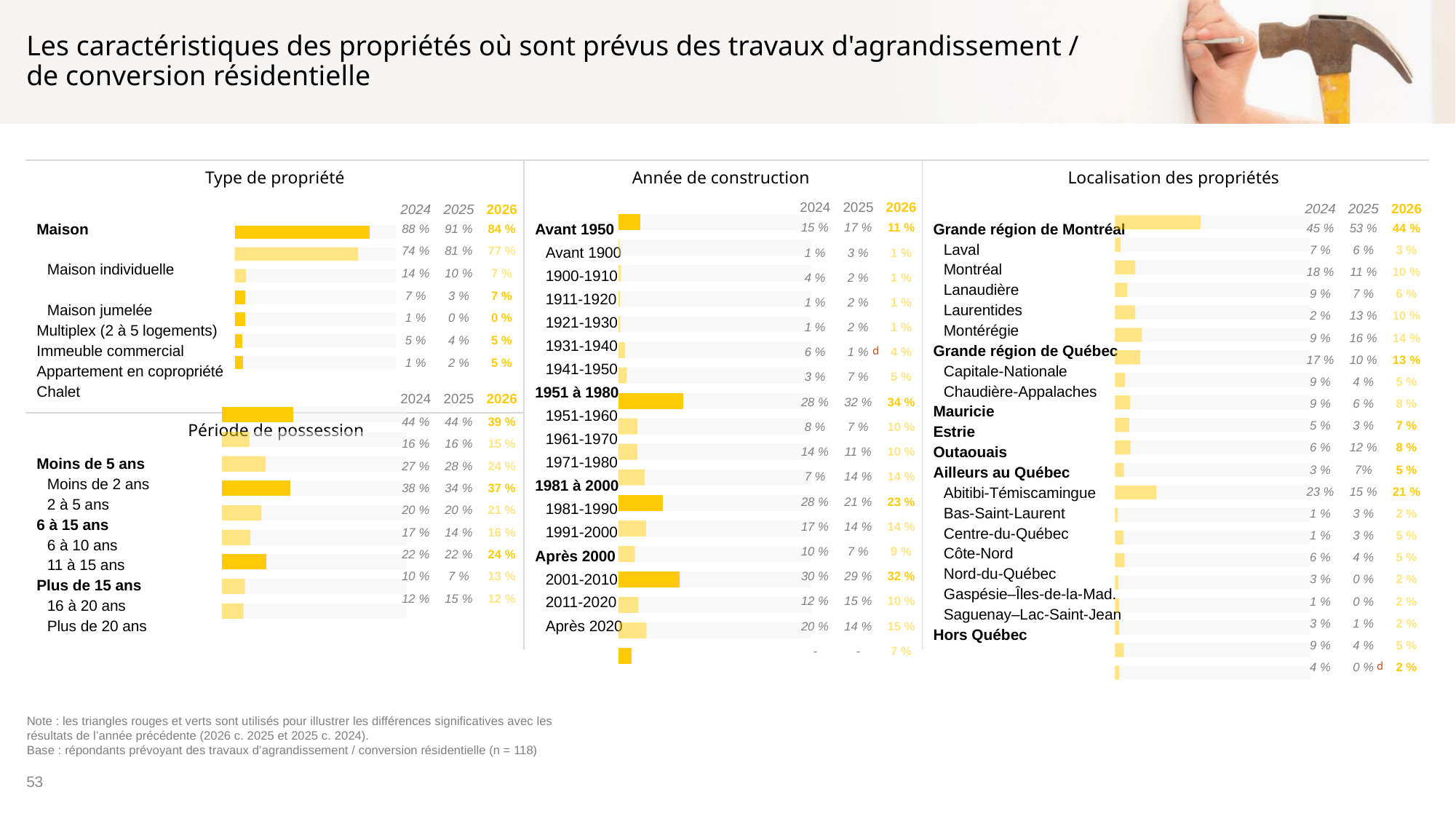
In the 'Type de propriété' chart, what was the 2025 value for Maison? 91 % In the 'Année de construction' chart, what is the 2026 value for Après 2020? 7 % In the 'Année de construction' chart, what is the 2026 value for 1951 à 1980? 34 % In the 'Localisation des propriétés' chart, what is the 2024 value for Ailleurs au Québec? 23 % In the 'Type de propriété' chart, how many year columns of values are shown? 3 In the 'Localisation des propriétés' chart, what is the 2026 value for Grande région de Montréal? 44 % In the 'Année de construction' chart, which is larger in 2026: 1951 à 1980 or Après 2000? 1951 à 1980 In the 'Type de propriété' chart, what is the 2026 value for Maison? 84 % In the 'Période de possession' chart, what is the 2026 value for Moins de 5 ans? 39 % What kind of chart is used in the 'Localisation des propriétés' section? Bar chart In the 'Période de possession' chart, what is the difference between the 2026 values for Moins de 5 ans and 6 à 15 ans? 2 % In the 'Type de propriété' chart, which category has the highest 2026 value? Maison